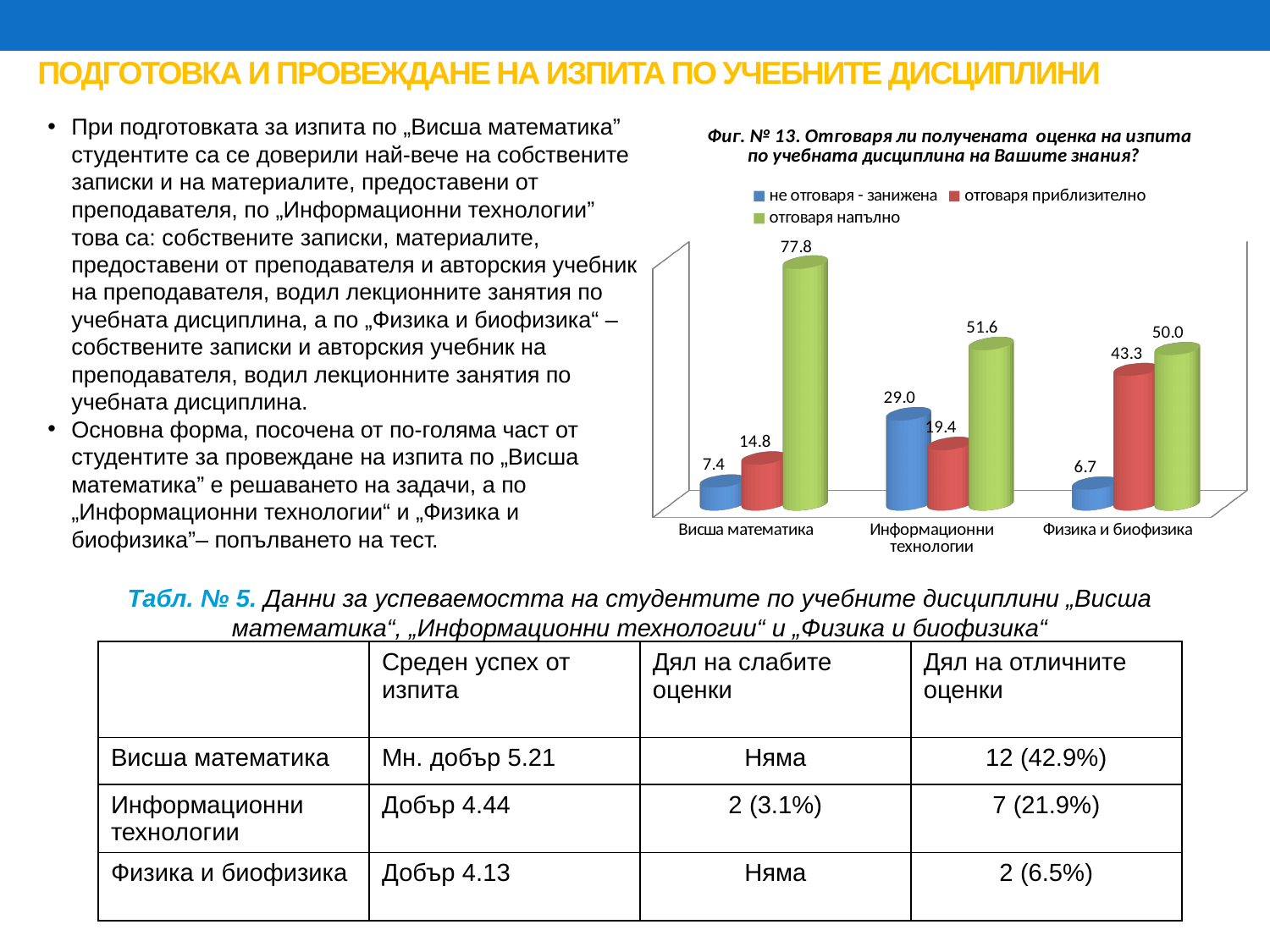
Which is larger for Информационни технологии: "не отговаря - занижена" or "отговаря приблизително"? не отговаря - занижена What is the value for "отговаря напълно" for Физика и биофизика? 50.0 What is the difference between the "отговаря напълно" values for Висша математика and Информационни технологии? 26.2 What is the value for "отговаря напълно" for Висша математика? 77.8 How many categories are shown on the x axis of the chart? 3 How many series does the chart legend list? 3 Which category has the lowest value for "не отговаря - занижена"? Физика и биофизика Which category has the highest value for "отговаря напълно"? Висша математика What is the value for "отговаря приблизително" for Физика и биофизика? 43.3 What is the value for "не отговаря - занижена" for Информационни технологии? 29.0 What kind of chart is shown on the slide? Bar chart What is the figure number of the chart on the slide? Фиг. № 13